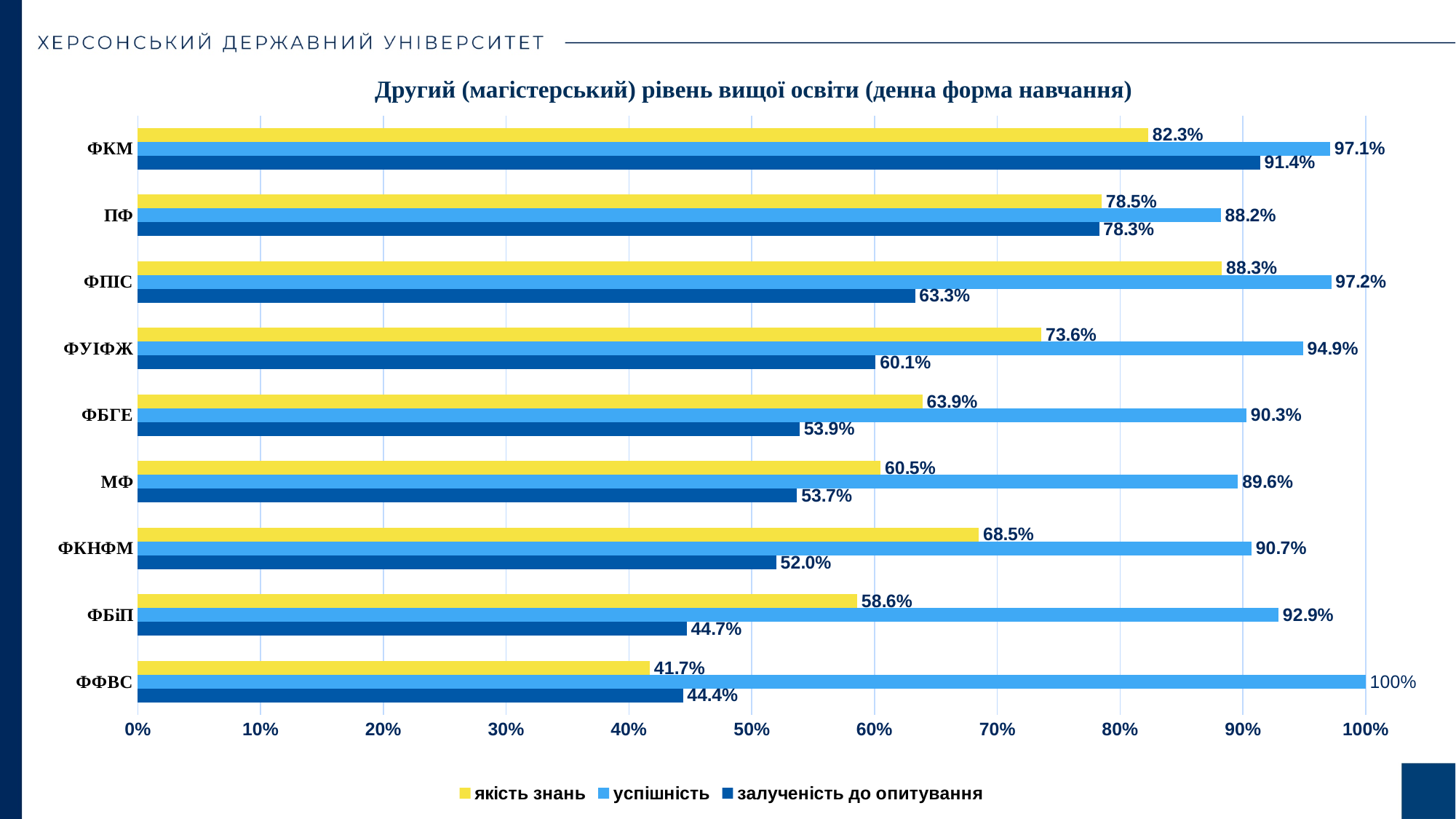
What is the успішність value for ФФВС? 100% How many categories are shown on the chart? 9 Which category has the highest залученість до опитування value? ФКМ What is the якість знань value for ФКМ? 82.3% Which category has the lowest якість знань value? ФФВС How many series does the legend list? 3 What is the difference between the успішність and залученість до опитування values for ФКМ? 5.7 percentage points Which category has the highest якість знань value? ФПІС What is the залученість до опитування value for ФБіП? 44.7% Which is larger: the якість знань value for ФКНФМ or for МФ? ФКНФМ What kind of chart is shown on the slide? Bar chart What is the title of the chart? Другий (магістерський) рівень вищої освіти (денна форма навчання)